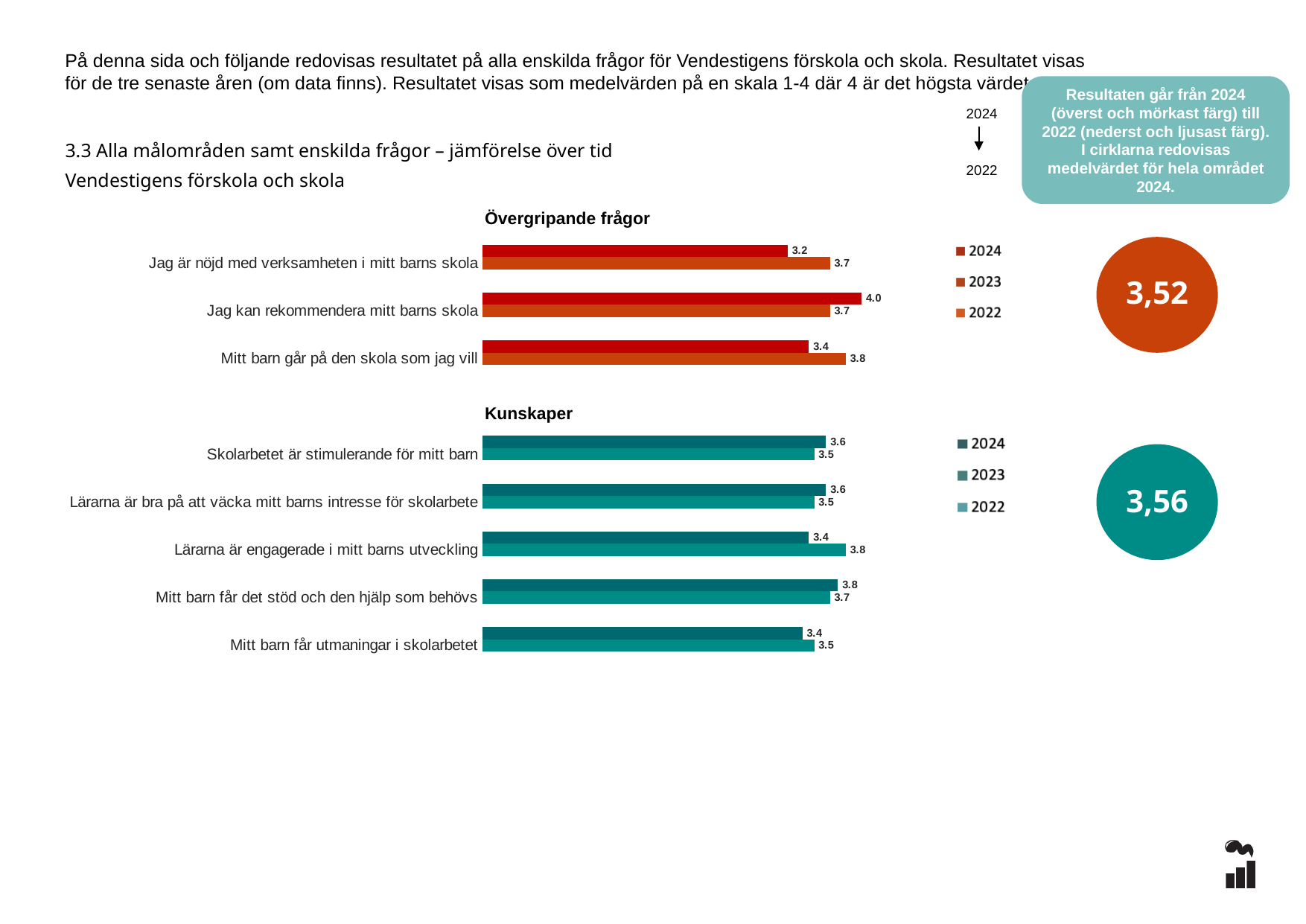
In the 'Kunskaper' chart, what is the lower bar value for 'Lärarna är engagerade i mitt barns utveckling'? 3.8 In the 'Övergripande frågor' chart, what is the 2024 value (top bar) for 'Jag kan rekommendera mitt barns skola'? 4.0 In the 'Övergripande frågor' chart, how many questions (categories) are shown? 3 In the 'Övergripande frågor' chart, which question has the highest 2024 value (top bar)? Jag kan rekommendera mitt barns skola What type of chart is used for 'Övergripande frågor'? Bar chart In the 'Övergripande frågor' chart, what is the difference between the top bar and the lower bar for 'Jag är nöjd med verksamheten i mitt barns skola'? 0.5 What is the overall 2024 mean value shown in the circle next to the 'Kunskaper' chart? 3,56 In the 'Kunskaper' chart, how many questions (categories) are shown? 5 In the 'Kunskaper' chart, which question has the highest 2024 value (top bar)? Mitt barn får det stöd och den hjälp som behövs In the 'Övergripande frågor' chart, what is the 2024 value (top bar) for 'Jag är nöjd med verksamheten i mitt barns skola'? 3.2 How many series does the legend of the 'Kunskaper' chart list? 3 In the 'Kunskaper' chart, what is the 2024 value (top bar) for 'Mitt barn får det stöd och den hjälp som behövs'? 3.8